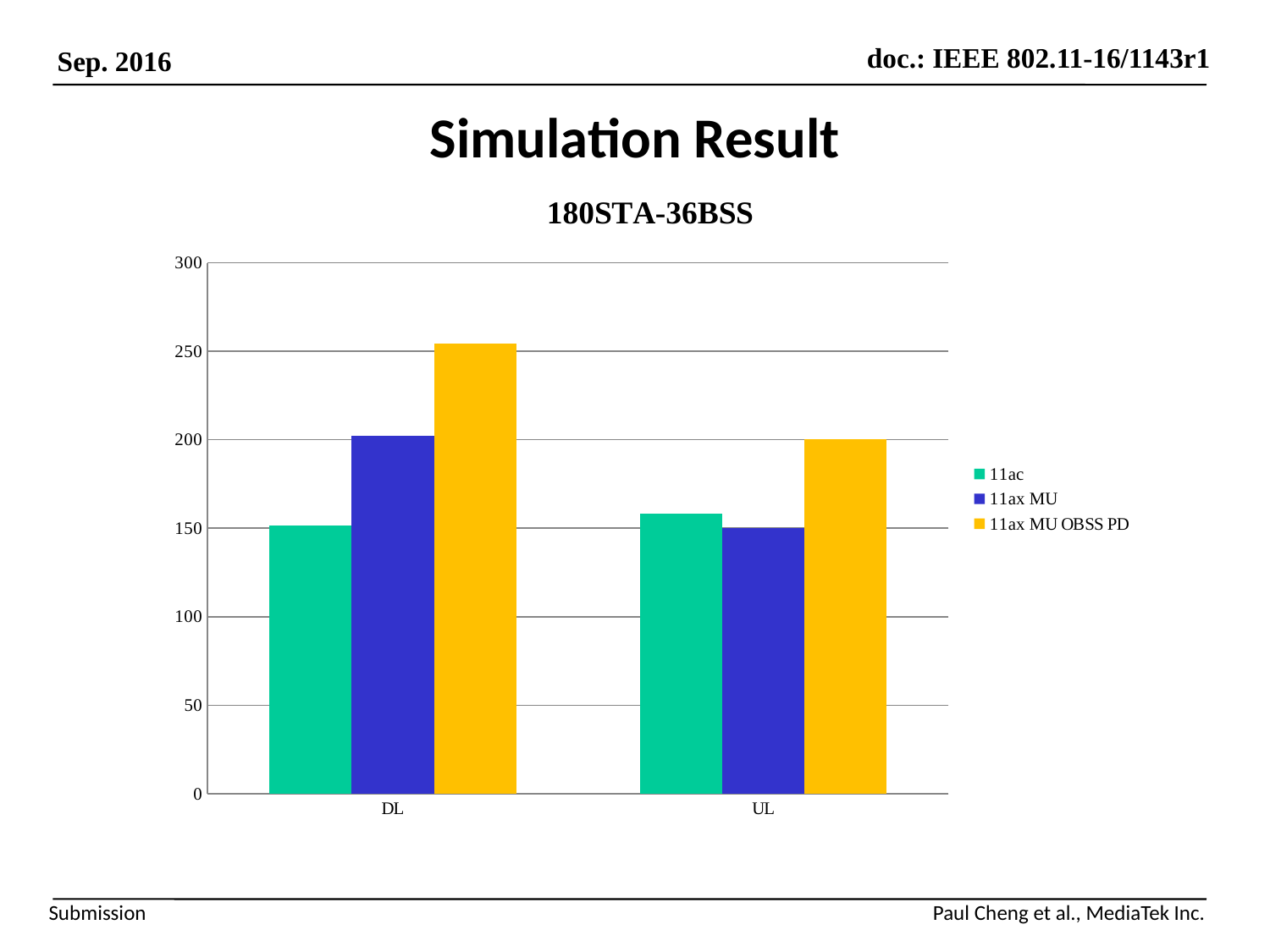
Is the value for 11ax MU OBSS PD in the DL category greater or less than 200? greater For the 11ax MU series, which category has the larger value, DL or UL? DL Is the value for 11ac in the DL category greater or less than 200? less How many series does the legend list? 3 What is the title of the chart? 180STA-36BSS Which series has the lowest bar in the DL category? 11ac Which series has the highest bar in the DL category? 11ax MU OBSS PD Which series has the highest bar in the UL category? 11ax MU OBSS PD Which colour represents the 11ax MU OBSS PD series? yellow Is the value for 11ax MU in the UL category greater or less than 100? greater What type of chart is shown on the slide? bar chart How many categories are shown on the x axis? 2